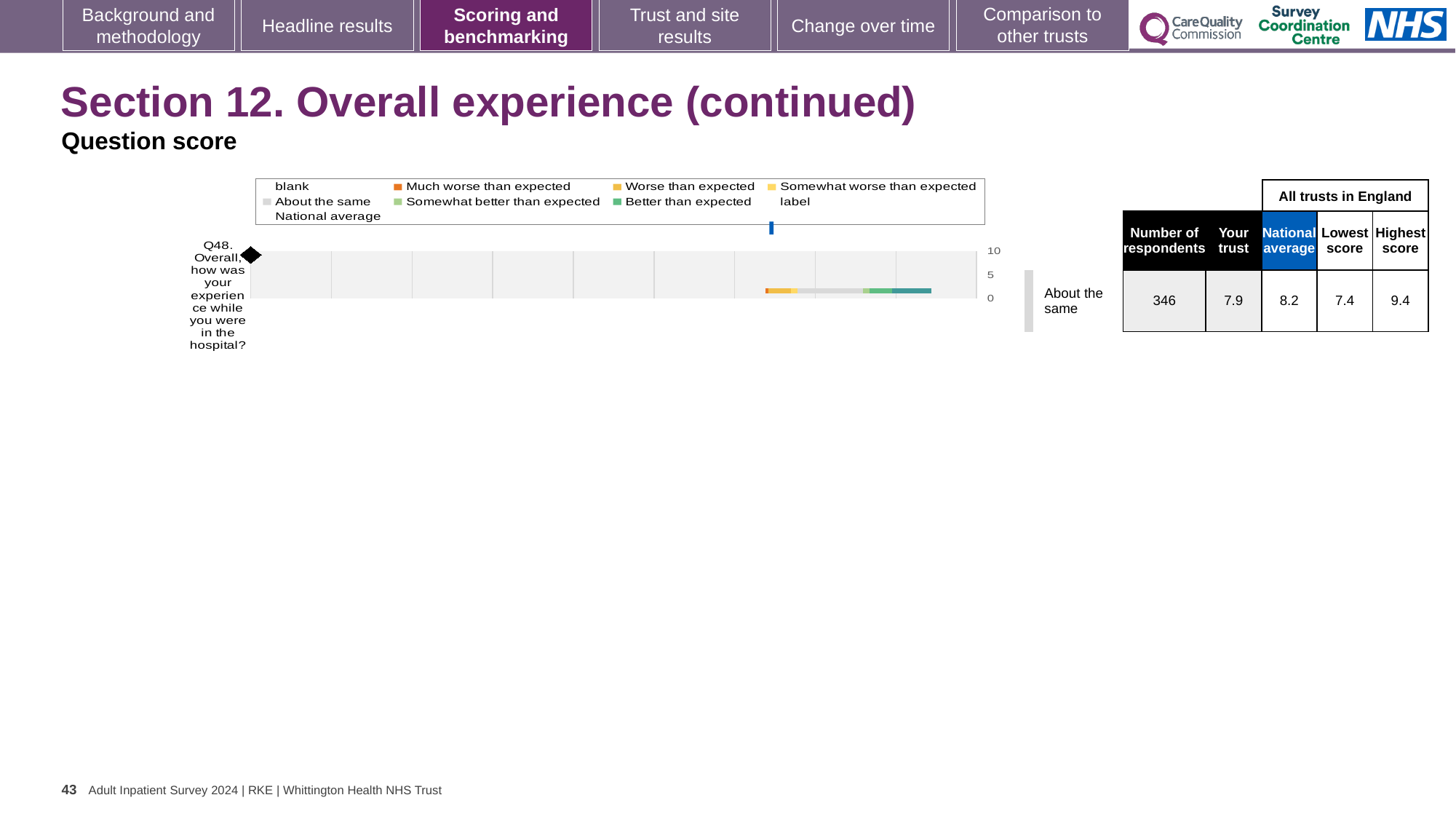
What is the national average score for Q48 shown in the table next to the chart? 8.2 How many respondents answered Q48? 346 Which is larger for Q48, the 'Your trust' score or the national average? National average What is the difference between the highest score and the lowest score for Q48? 2.0 What is the difference between the national average and the 'Your trust' score for Q48? 0.3 How many survey questions are plotted in the chart? 1 What is the highest score among all trusts in England for Q48? 9.4 What is the lowest score among all trusts in England for Q48? 7.4 What is the 'Your trust' score for Q48 shown in the table next to the chart? 7.9 Which survey question is plotted in the chart? Q48. Overall, how was your experience while you were in the hospital? What benchmarking category is the trust's Q48 result placed in? About the same What type of chart is used to show the Q48 question score? Bar chart